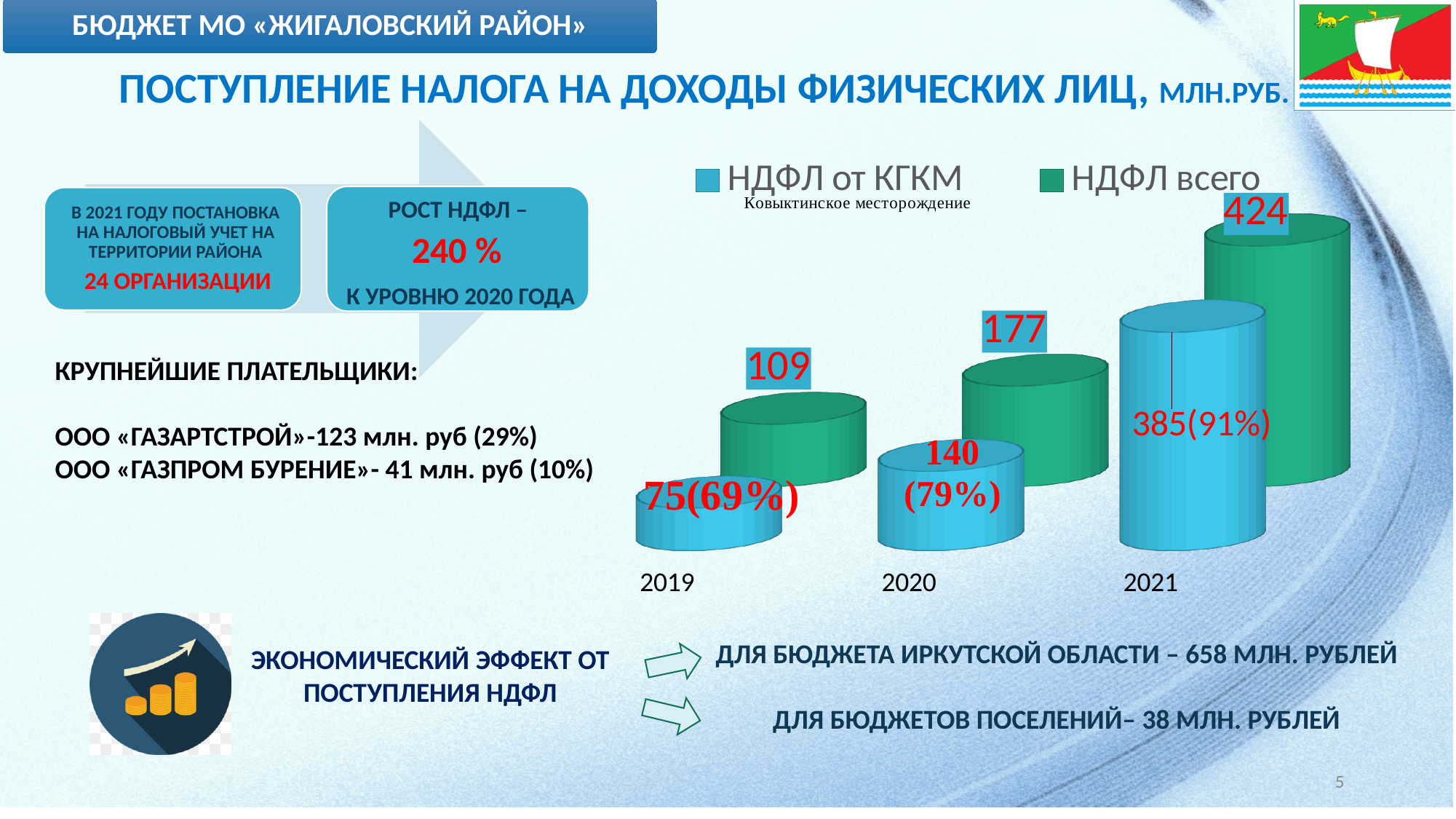
What is the difference between НДФЛ всего in 2021 and in 2020? 247 What data label is shown for НДФЛ от КГКМ in 2021? 385(91%) How many years are shown on the x axis of the chart? 3 What is the value of НДФЛ всего for 2019? 109 Which year has the lowest value of НДФЛ от КГКМ? 2019 Which is larger in 2020: НДФЛ всего or НДФЛ от КГКМ? НДФЛ всего How many series does the chart legend list? 2 What data label is shown for НДФЛ от КГКМ in 2020? 140 (79%) What is the value of НДФЛ всего for 2021? 424 Which year has the highest value of НДФЛ всего? 2021 What is the difference between НДФЛ всего and НДФЛ от КГКМ in 2019? 34 Does НДФЛ всего rise or fall from 2019 to 2021? rise